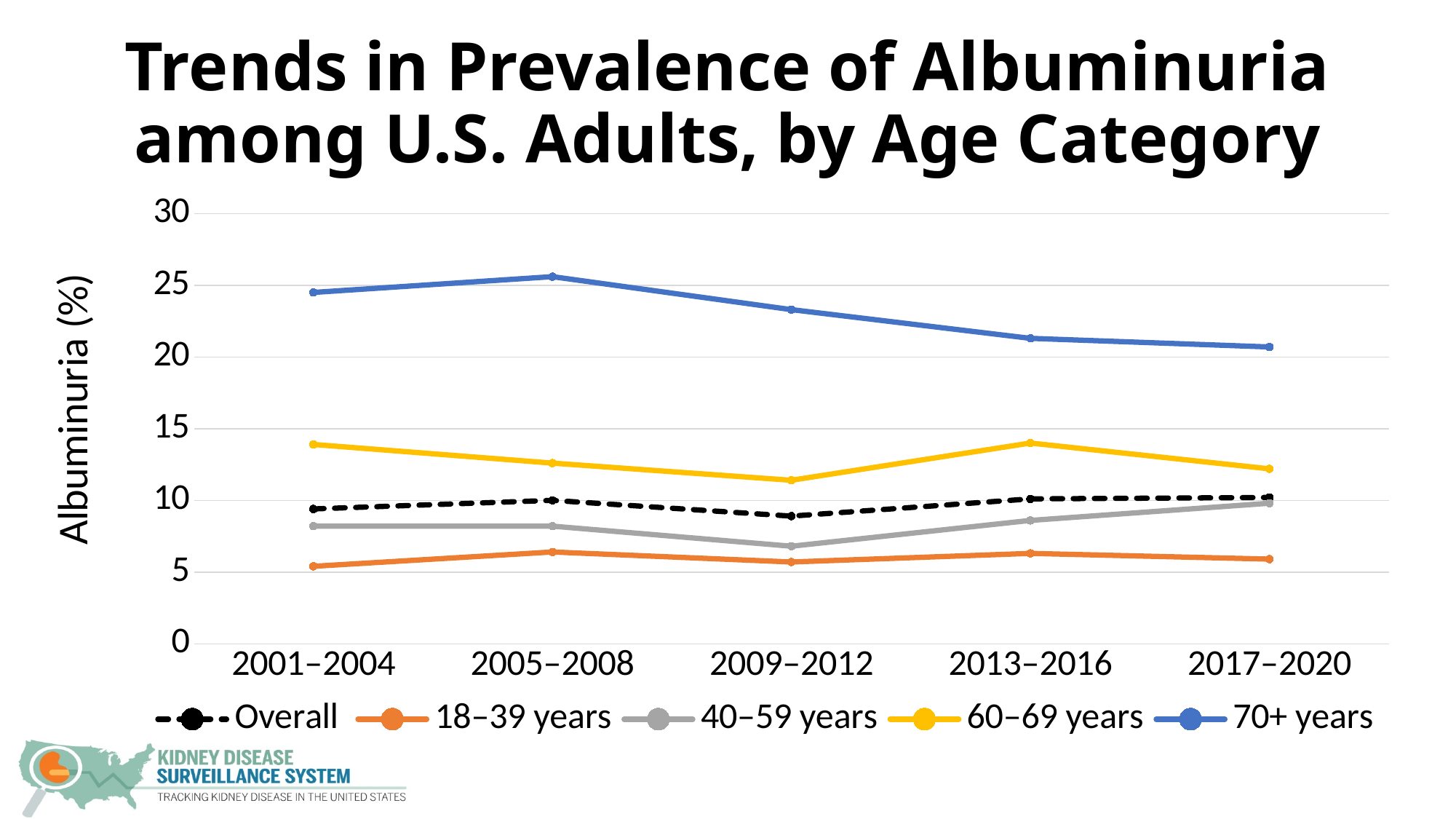
Does the albuminuria prevalence for 40–59 years rise or fall from 2009–2012 to 2017–2020? rise Is the value for 60–69 years in 2001–2004 greater or less than 10? greater Does the albuminuria prevalence for 70+ years rise or fall from 2005–2008 to 2017–2020? fall Is the value for 18–39 years in 2009–2012 greater or less than 10? less What kind of chart is shown on the slide? line chart Is the value for 70+ years in 2009–2012 greater or less than 25? less How many time periods are shown on the x axis? 5 What is the label on the y axis? Albuminuria (%) Which age category has the lowest albuminuria prevalence in every time period? 18–39 years In 2013–2016, which is larger: the value for 60–69 years or the value for 40–59 years? 60–69 years How many series does the legend list? 5 Which age category has the highest albuminuria prevalence in every time period? 70+ years